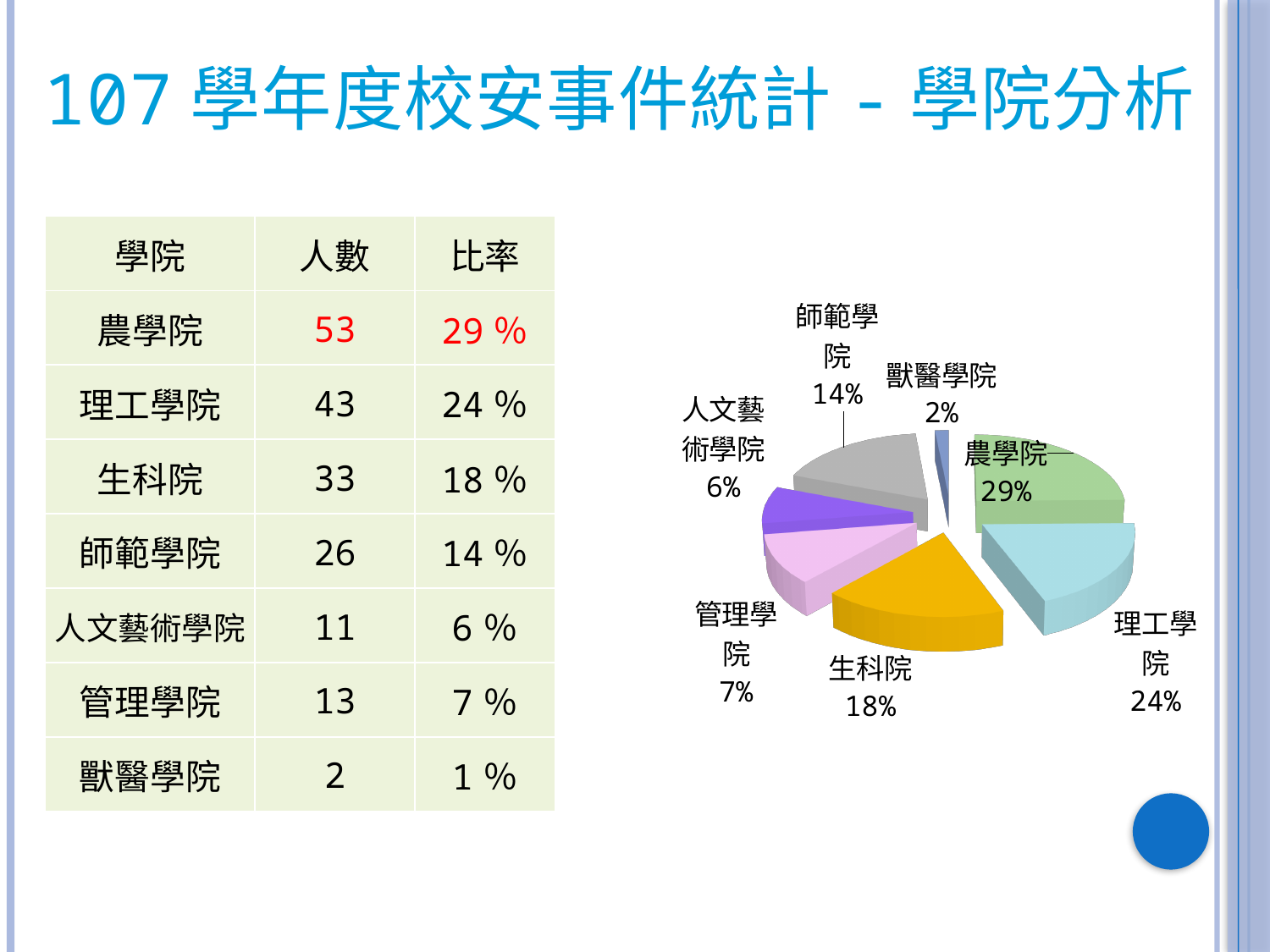
What percentage is labelled for 管理學院 in the pie chart? 7% What kind of chart is shown on the slide? pie chart Which slice of the pie chart is the smallest? 獸醫學院 What share of the pie chart does 農學院 hold? 29% Which slice of the pie chart is the largest? 農學院 In the pie chart, which is larger, 生科院 or 師範學院? 生科院 What percentage is labelled for 人文藝術學院 in the pie chart? 6% How many slices does the pie chart have? 7 What share of the pie chart does 師範學院 hold? 14% What is the difference in percentage points between the 農學院 and 理工學院 slices in the pie chart? 5 What share of the pie chart does 生科院 hold? 18%